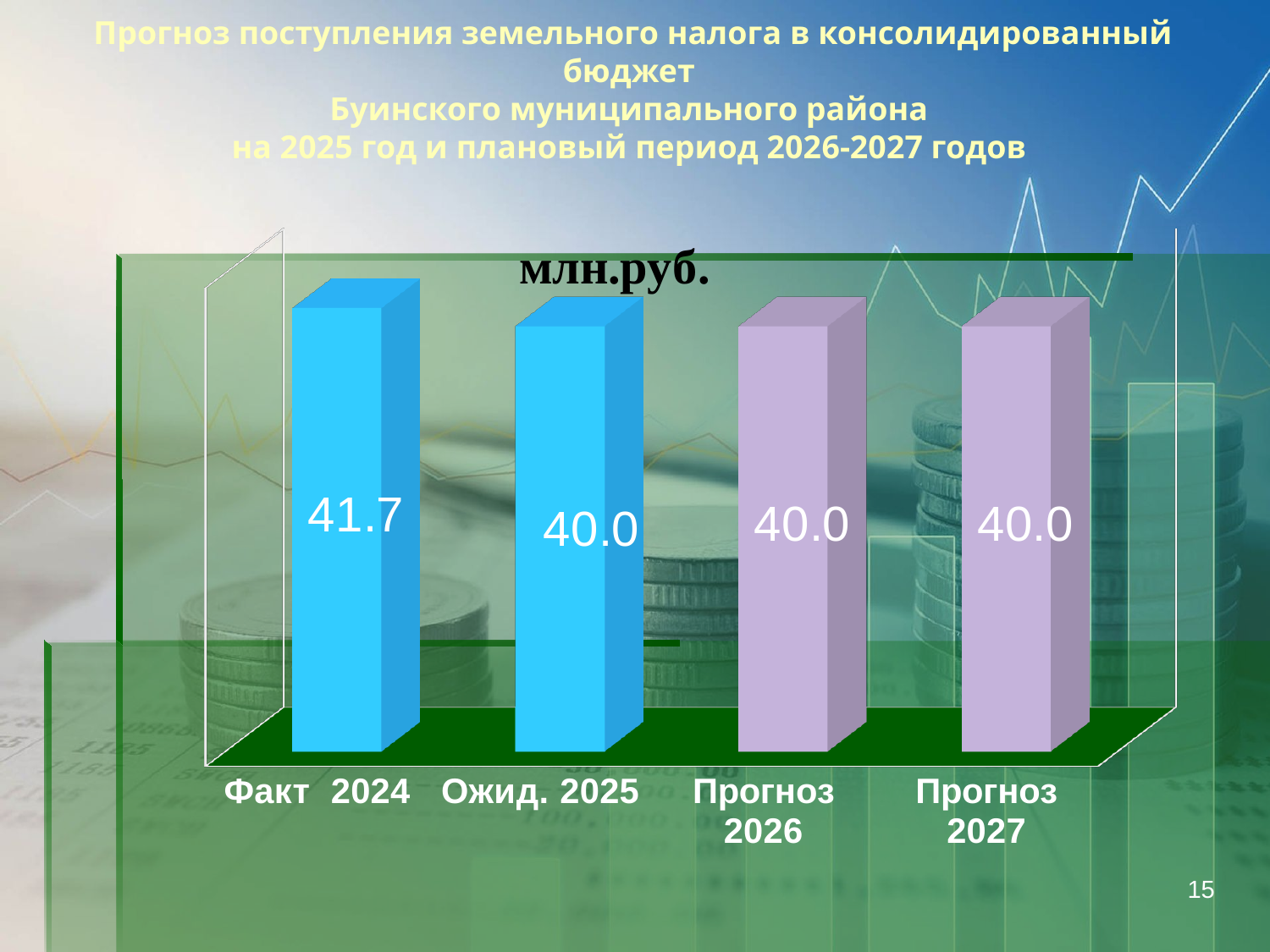
What is the difference between the values for Факт 2024 and Ожид. 2025? 1.7 What colour are the bars for Прогноз 2026 and Прогноз 2027? Purple What is the value for Ожид. 2025? 40.0 What is the value for Факт 2024? 41.7 How many categories are shown in the chart? 4 What kind of chart is shown on the slide? Bar chart What unit is shown above the chart? млн.руб. Which category has the highest value? Факт 2024 What is the value for Прогноз 2026? 40.0 What is the value for Прогноз 2027? 40.0 Which is larger, the value for Факт 2024 or the value for Прогноз 2027? Факт 2024 Do the values rise or fall from Факт 2024 to Ожид. 2025? Fall